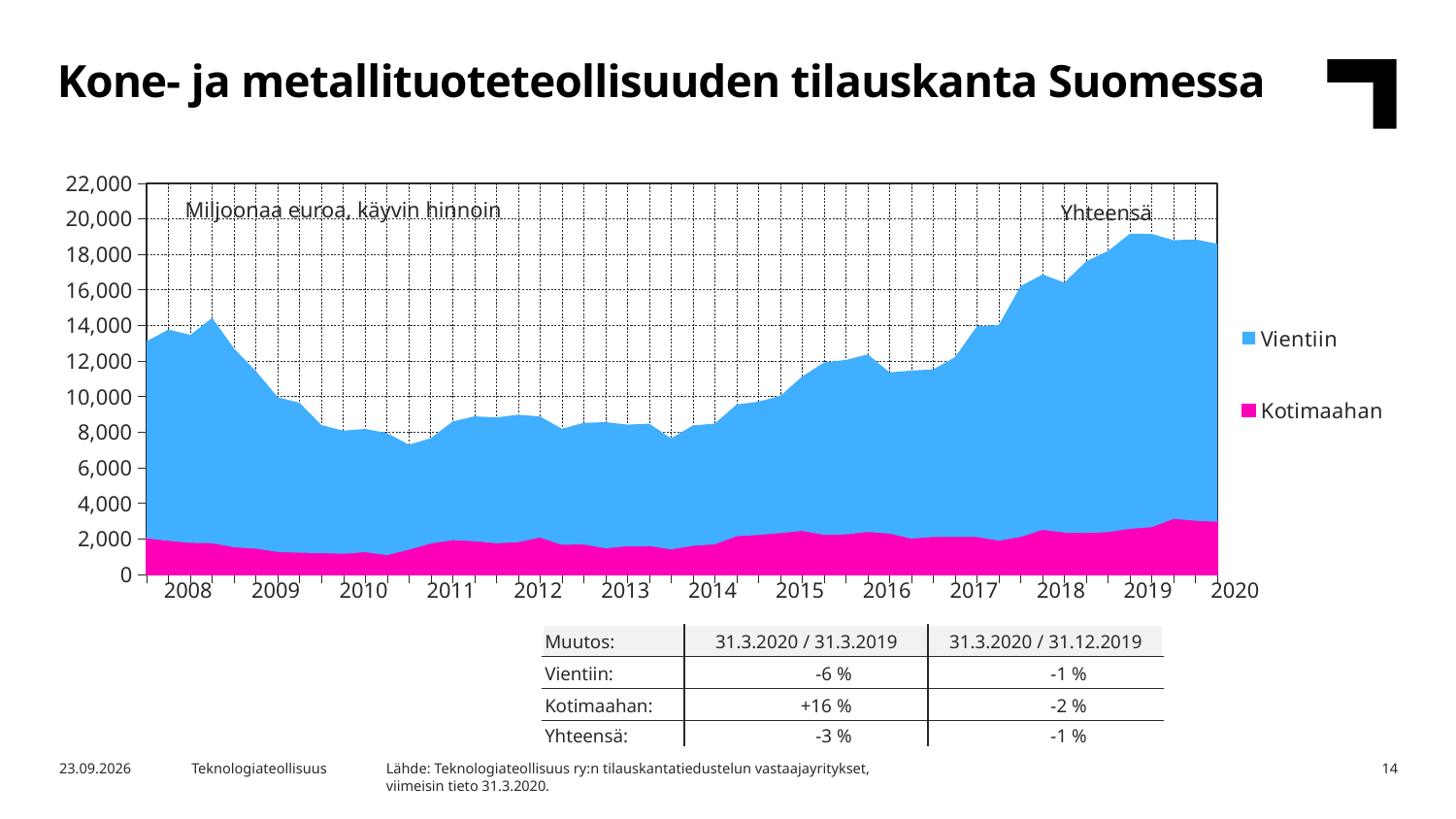
Is the total (Yhteensä) value in 2010 greater or less than 10,000? less What kind of chart is shown on the slide? Stacked area chart Does the total order book rise or fall between 2016 and 2019? rise Is the total (Yhteensä) value at the start of 2008 greater or less than 12,000? greater Which is larger in 2018, the Vientiin series or the Kotimaahan series? Vientiin What are the two series named in the chart legend? Vientiin and Kotimaahan Is the total (Yhteensä) value at the start of 2019 greater or less than 16,000? greater Does the total order book rise or fall between 2008 and 2010? fall What is the title of the chart on the slide? Kone- ja metallituoteteollisuuden tilauskanta Suomessa How many series does the chart legend list? 2 How many year labels are shown on the x axis of the chart? 13